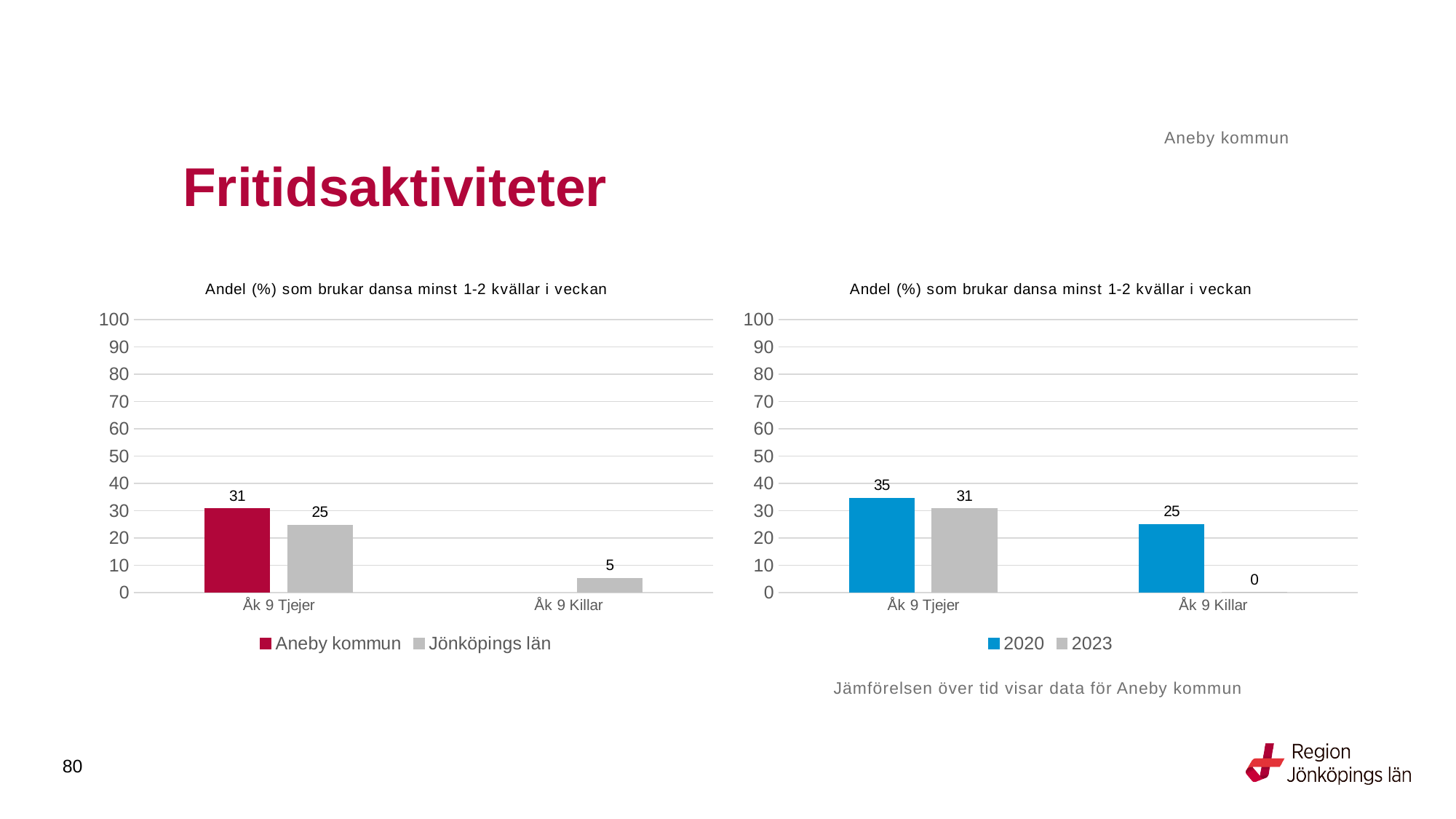
What kind of chart is the right chart? Bar chart In the left chart, what is the difference between Aneby kommun and Jönköpings län for Åk 9 Tjejer? 6 In the right chart, is the 2020 value for Åk 9 Killar greater or less than 20? greater In the right chart, what is the value for 2020 for Åk 9 Tjejer? 35 In the left chart, which series has the higher value for Åk 9 Tjejer, Aneby kommun or Jönköpings län? Aneby kommun In the right chart, which category has the highest 2020 value? Åk 9 Tjejer In the right chart, what is the difference between the 2020 and 2023 values for Åk 9 Tjejer? 4 In the right chart, what is the value for 2023 for Åk 9 Killar? 0 In the left chart, how many series does the legend list? 2 How many categories are shown on the x axis of the left chart? 2 In the left chart, what is the value for Jönköpings län for Åk 9 Killar? 5 In the left chart, what is the value for Aneby kommun for Åk 9 Tjejer? 31